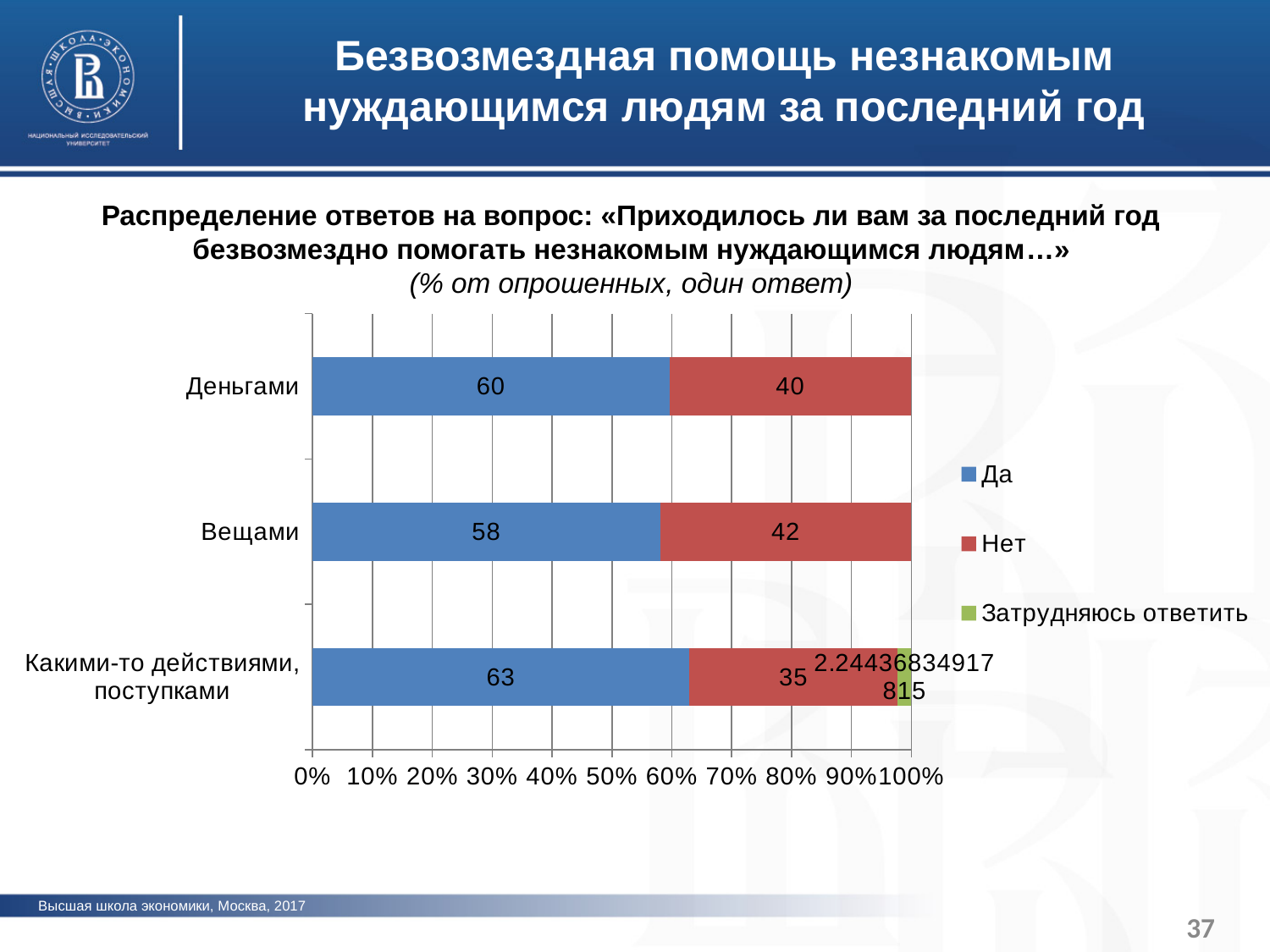
What is the value of "Нет" for "Какими-то действиями, поступками"? 35 What is the value of "Да" for "Деньгами"? 60 What is the value of "Да" for "Какими-то действиями, поступками"? 63 Which category has the highest value for "Да"? Какими-то действиями, поступками What is the total of the stacked bar for "Деньгами"? 100 Which category has the lowest value for "Нет"? Какими-то действиями, поступками What is the value of "Нет" for "Вещами"? 42 How many series does the legend list? 3 How many categories are shown on the chart? 3 What is the difference between the "Да" values for "Деньгами" and "Вещами"? 2 What type of chart is shown on the slide? bar chart Which is larger: the "Нет" value for "Деньгами" or for "Вещами"? Вещами